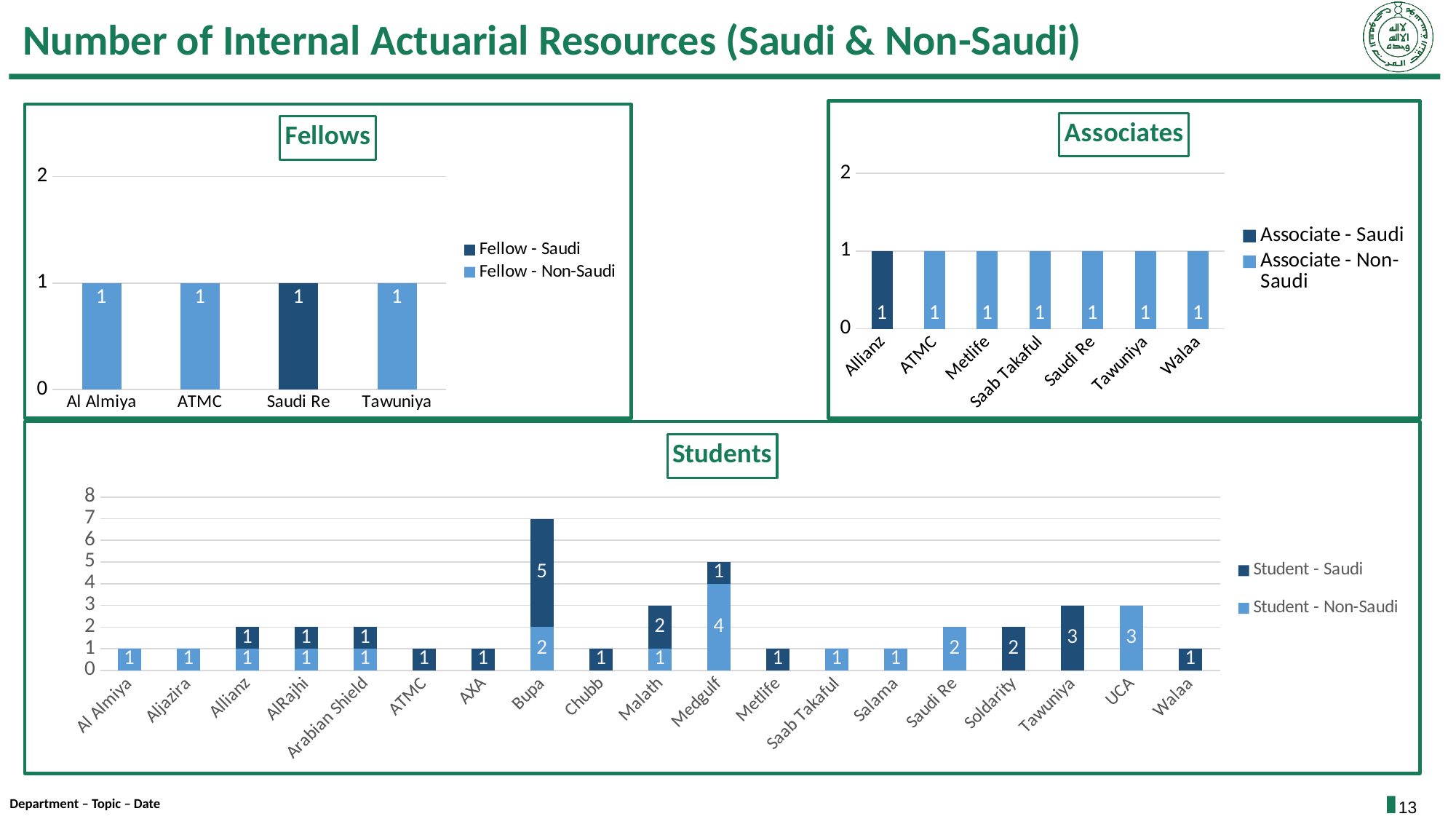
In the Students chart, what is the Student - Non-Saudi value for Medgulf? 4 In the Students chart, which is larger: the Student - Non-Saudi value for UCA or the Student - Non-Saudi value for Saudi Re? UCA How many series does the legend of the Associates chart list? 2 In the Students chart, what is the total height of the stacked bar for Malath? 3 What type of chart is the Fellows chart? Bar chart How many companies are shown on the x axis of the Students chart? 19 In the Fellows chart, which company is the only one with a Fellow - Saudi bar? Saudi Re In the Students chart, what is the total height of the stacked bar for Bupa? 7 How many companies are shown on the x axis of the Associates chart? 7 In the Students chart, what is the Student - Saudi value for Bupa? 5 In the Students chart, what is the difference between the Student - Saudi value for Bupa and the Student - Saudi value for Tawuniya? 2 In the Students chart, which company has the tallest stacked bar? Bupa